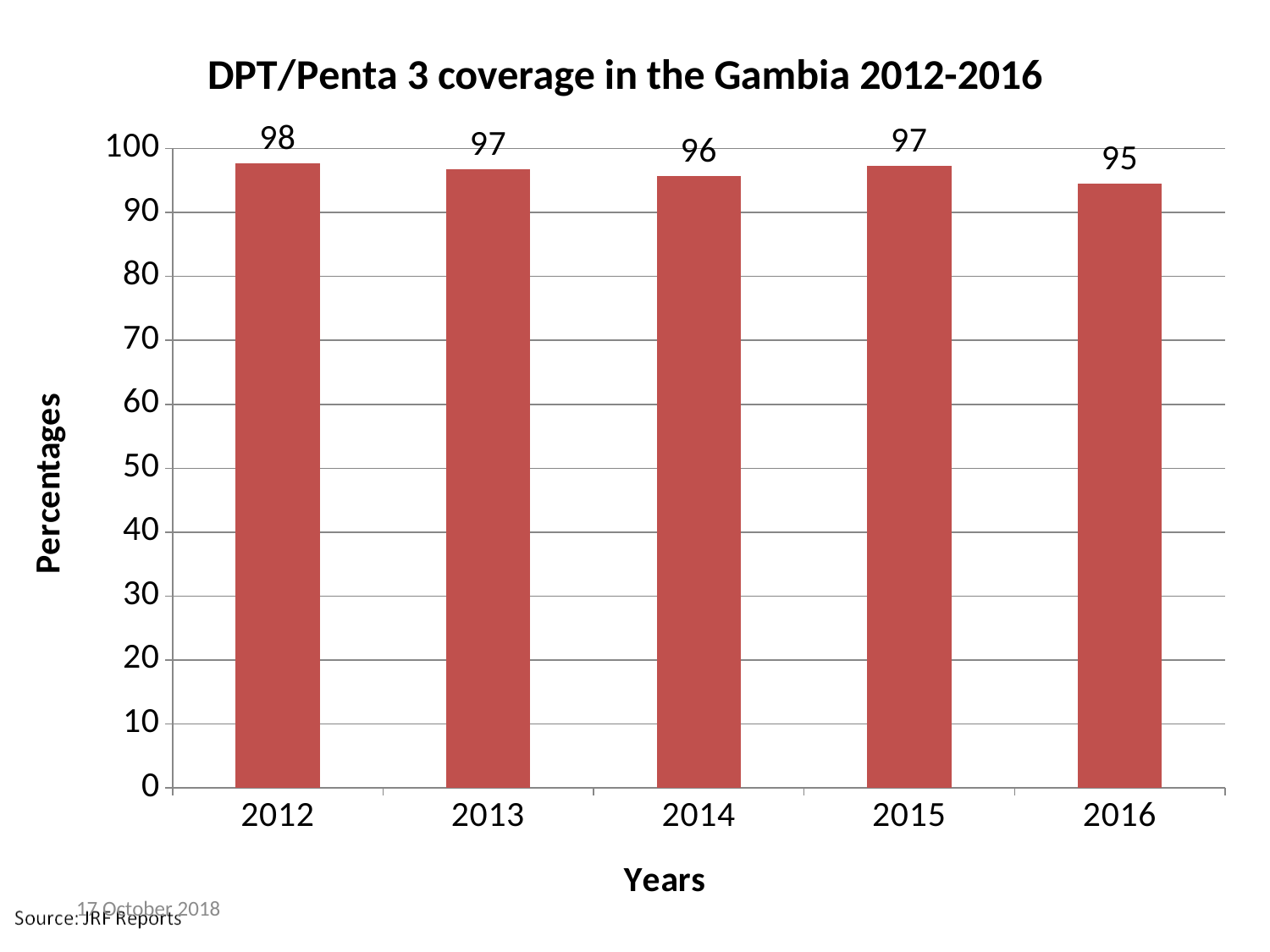
What is the difference between the coverage values for 2012 and 2016? 3 What is the DPT/Penta 3 coverage value for 2016? 95 Do the coverage values generally rise or fall from 2012 to 2016? Fall What is the DPT/Penta 3 coverage value for 2014? 96 What kind of chart is shown on the slide? Bar chart Which year has a higher coverage value, 2013 or 2014? 2013 How many years are shown on the x axis of the chart? 5 Is the value for 2015 greater or less than 90? greater What is the DPT/Penta 3 coverage value for 2012? 98 Which year has the lowest DPT/Penta 3 coverage? 2016 What is the title of the chart? DPT/Penta 3 coverage in the Gambia 2012-2016 Which year has the highest DPT/Penta 3 coverage? 2012